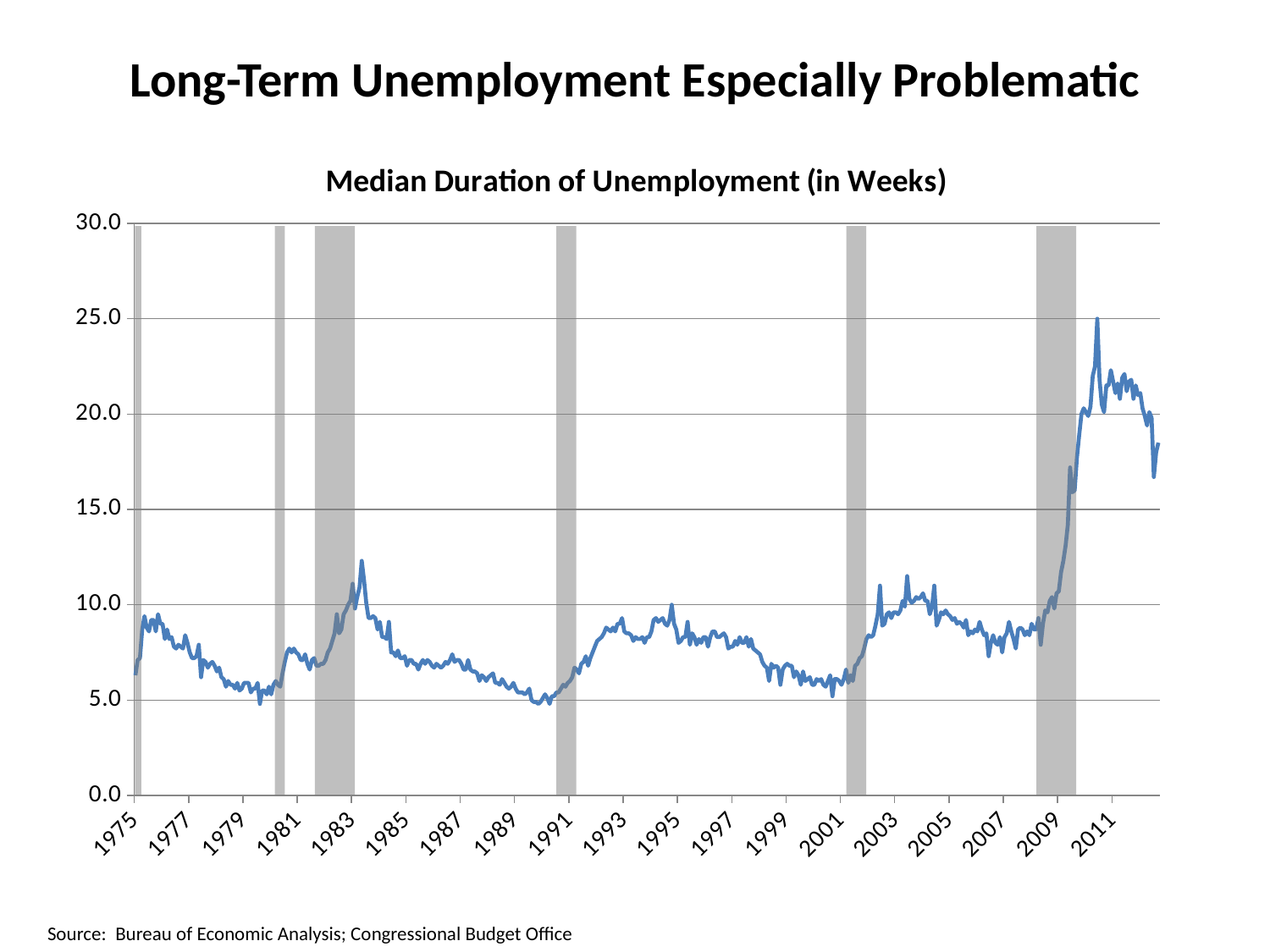
Around which year does the line reach its highest point? 2010 What source is cited for the chart? Bureau of Economic Analysis; Congressional Budget Office What is the title of the chart? Median Duration of Unemployment (in Weeks) Does the line rise or fall between 2009 and 2010? rise Does the line rise or fall between 1983 and 1989? fall Is the peak value the line reaches around 1983 greater or less than 10.0? greater Is the peak value the line reaches around 2010 greater or less than 20.0? greater What kind of chart is shown on the slide? line chart Is the lowest value on the line greater or less than 10.0? less Which is larger, the value for 2011 or the value for 1995? 2011